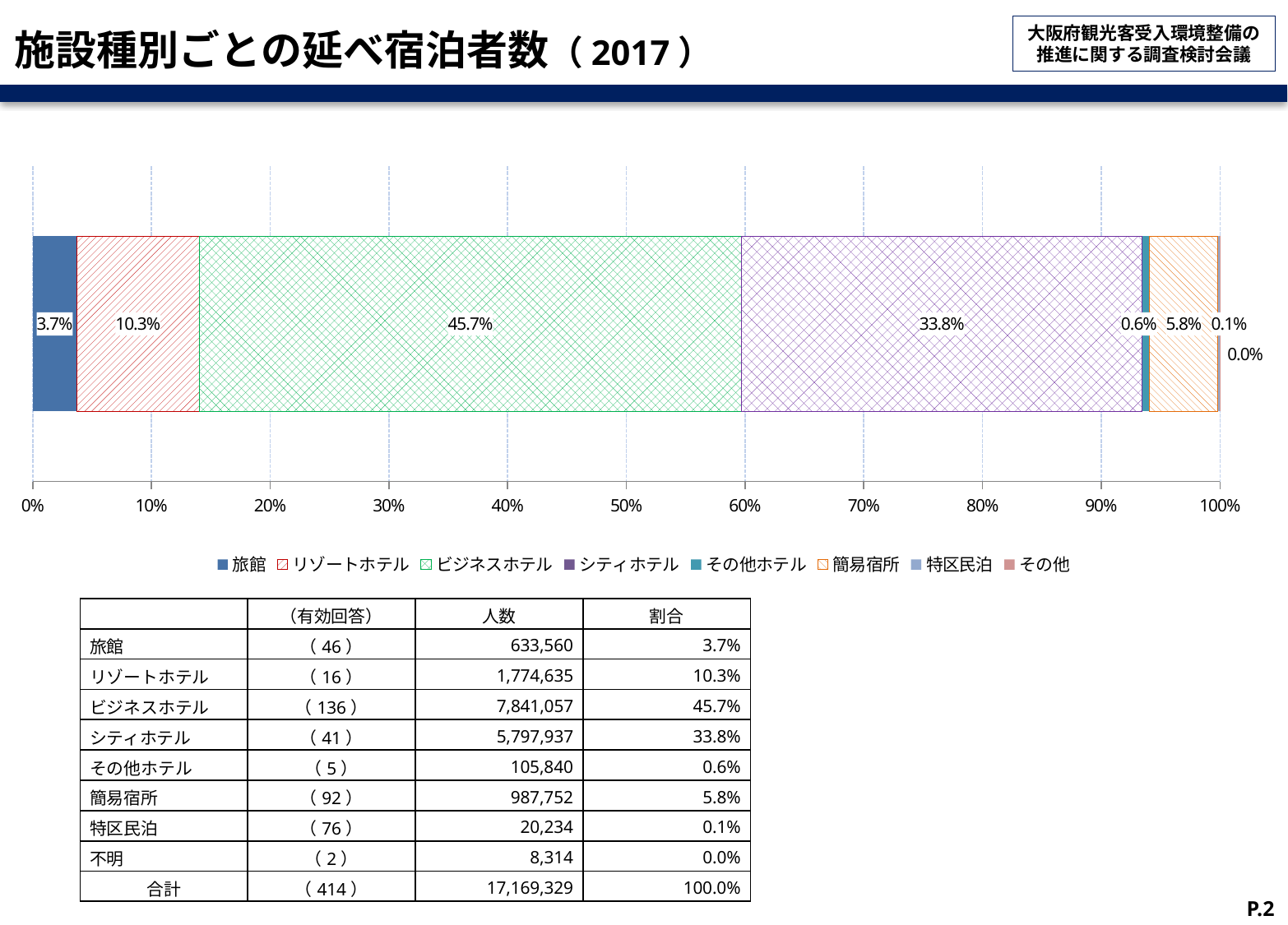
What is the value shown for 簡易宿所 in the chart? 5.8% Which series has the largest share of the bar? ビジネスホテル What is the difference between the values for ビジネスホテル and シティホテル? 11.9% What is the value shown for シティホテル in the chart? 33.8% What is the combined value of 旅館 and リゾートホテル? 14.0% Which series has the smallest share of the bar? その他 What kind of chart is shown on the slide? stacked bar chart What is the value shown for ビジネスホテル in the chart? 45.7% What is the title of the slide's chart? 施設種別ごとの延べ宿泊者数（2017） What is the value shown for リゾートホテル in the chart? 10.3% Which is larger, the value for 旅館 or the value for 簡易宿所? 簡易宿所 How many series does the legend list? 8